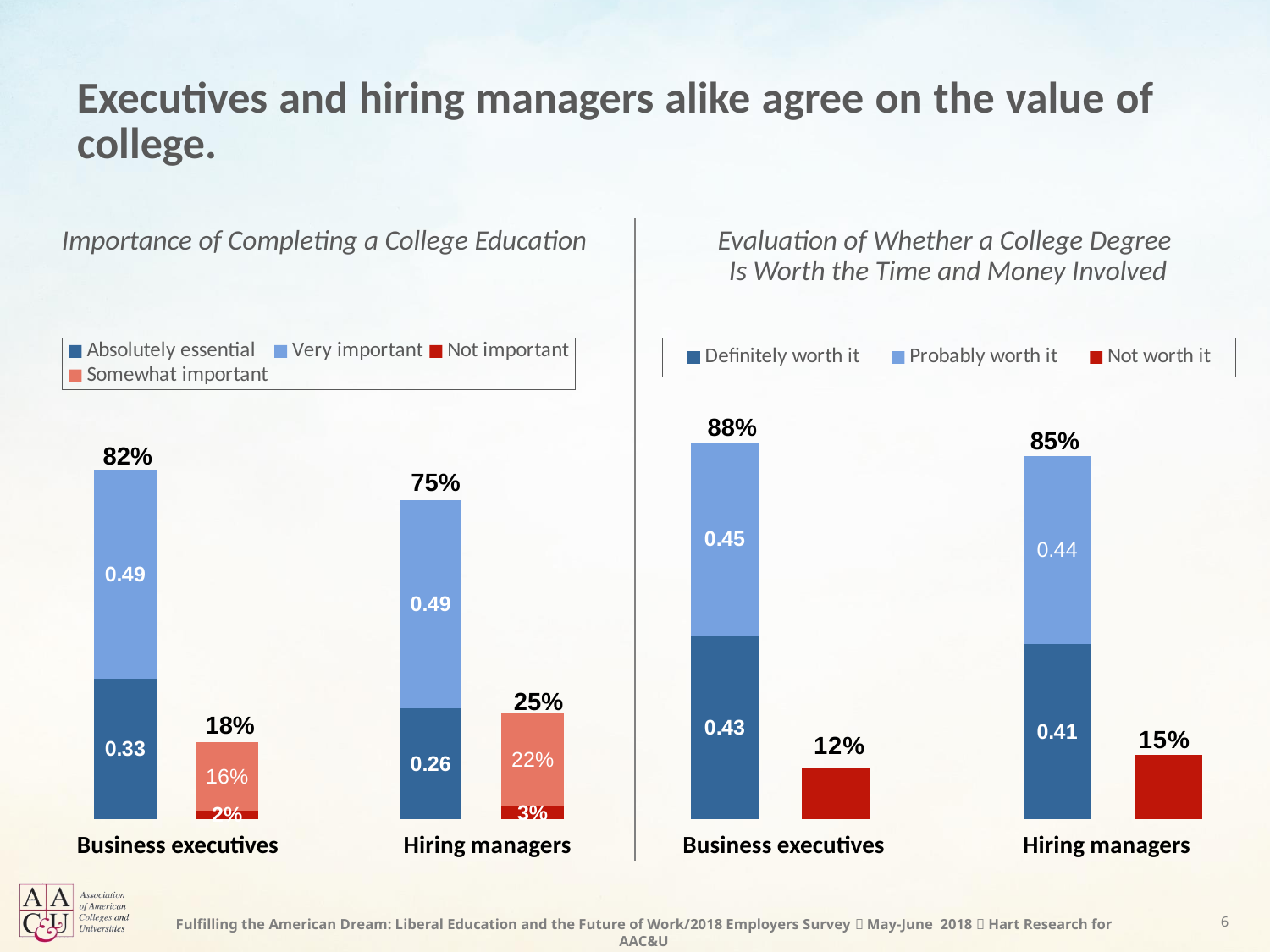
In the 'Evaluation of Whether a College Degree Is Worth the Time and Money Involved' chart, what is the total of the stacked 'worth it' bar for Business executives? 88% In the 'Evaluation of Whether a College Degree Is Worth the Time and Money Involved' chart, what is the 'Definitely worth it' value for Hiring managers? 0.41 In the 'Importance of Completing a College Education' chart, what is the 'Not important' value for Business executives? 2% In the 'Importance of Completing a College Education' chart, what is the 'Absolutely essential' value for Business executives? 0.33 In the 'Importance of Completing a College Education' chart, how many series does the legend list? 4 In the 'Importance of Completing a College Education' chart, what is the combined total of the 'Absolutely essential' and 'Very important' bar for Hiring managers? 75% What kind of chart is the 'Importance of Completing a College Education' chart? Stacked bar chart In the 'Evaluation of Whether a College Degree Is Worth the Time and Money Involved' chart, what is the difference between the 'Not worth it' values for Hiring managers and Business executives? 3% In the 'Evaluation of Whether a College Degree Is Worth the Time and Money Involved' chart, how many series does the legend list? 3 In the 'Evaluation of Whether a College Degree Is Worth the Time and Money Involved' chart, which group has the larger 'Probably worth it' value, Business executives or Hiring managers? Business executives In the 'Importance of Completing a College Education' chart, what is the 'Somewhat important' value for Hiring managers? 22% In the 'Evaluation of Whether a College Degree Is Worth the Time and Money Involved' chart, what is the 'Not worth it' value for Business executives? 12%